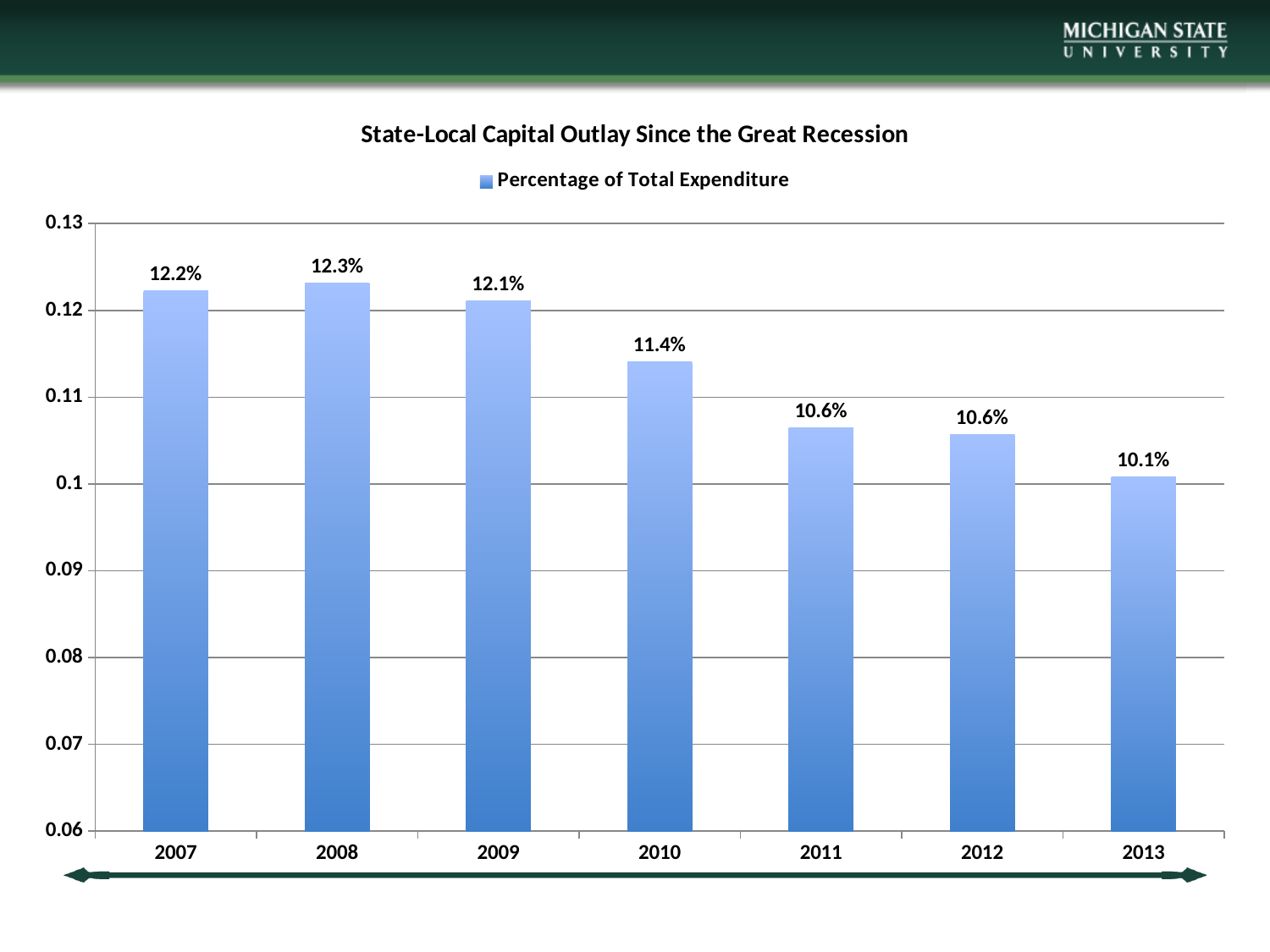
What kind of chart is shown on the slide? bar chart Which year has the lowest percentage of total expenditure? 2013 What is the percentage of total expenditure for 2013? 10.1% Is the value for 2011 greater or less than 0.11? less Which is larger, the value for 2009 or the value for 2010? 2009 What is the percentage of total expenditure for 2008? 12.3% What is the percentage of total expenditure for 2010? 11.4% What is the difference between the 2007 value and the 2013 value? 2.1% How many series does the legend list? 1 How many years are shown on the x axis? 7 Do the values generally rise or fall from 2008 to 2013? fall Which year has the highest percentage of total expenditure? 2008